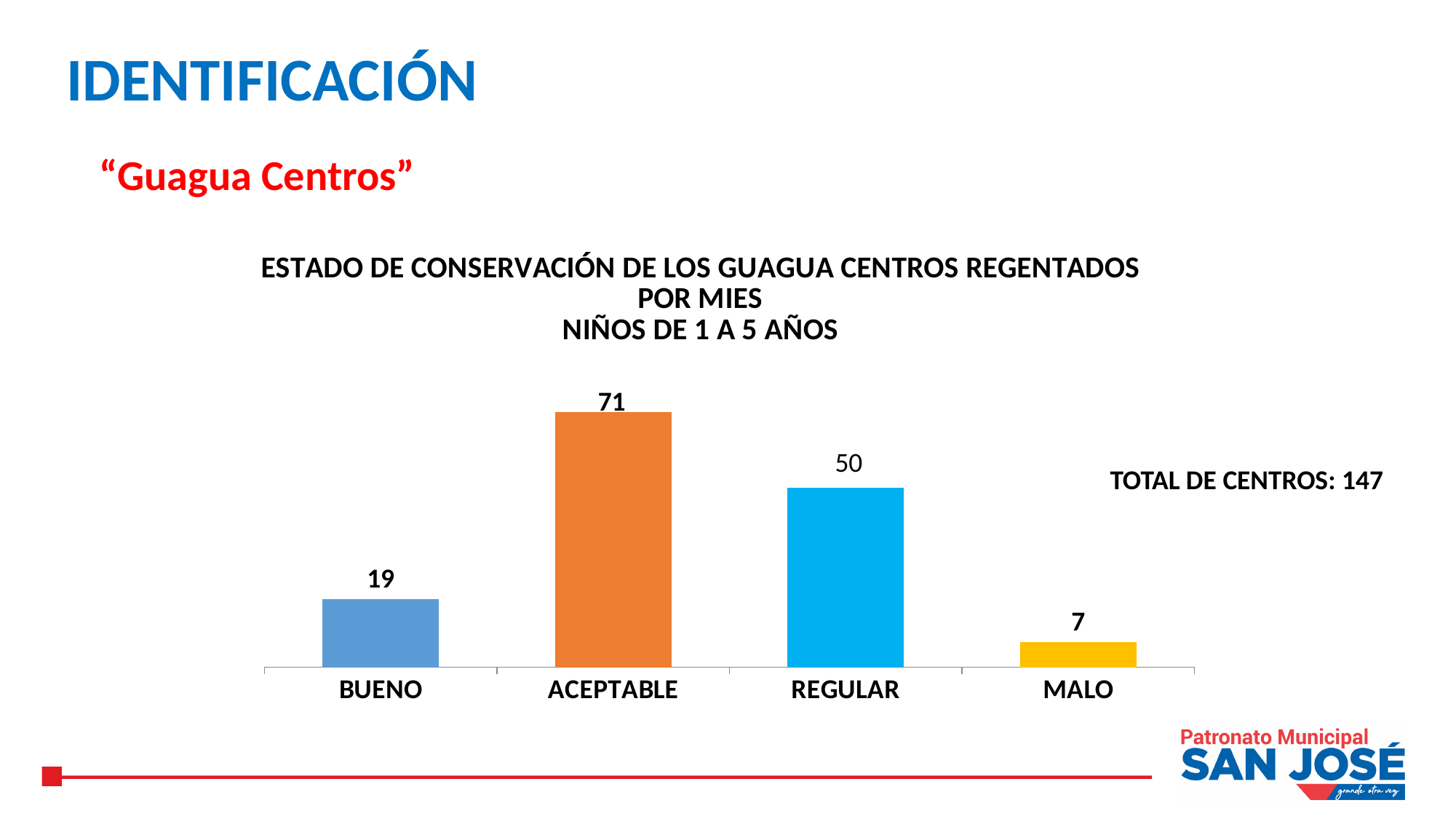
How many categories are shown on the x axis? 4 What is the value for ACEPTABLE? 71 What is the value for BUENO? 19 What is the difference between the values for BUENO and MALO? 12 What is the value for REGULAR? 50 What is the value for MALO? 7 Which category has the lowest value? MALO Which is larger, the value for REGULAR or the value for BUENO? REGULAR Which category has the highest value? ACEPTABLE What is the difference between the values for ACEPTABLE and REGULAR? 21 What colour is the bar for MALO? Yellow What kind of chart is shown on the slide? Bar chart